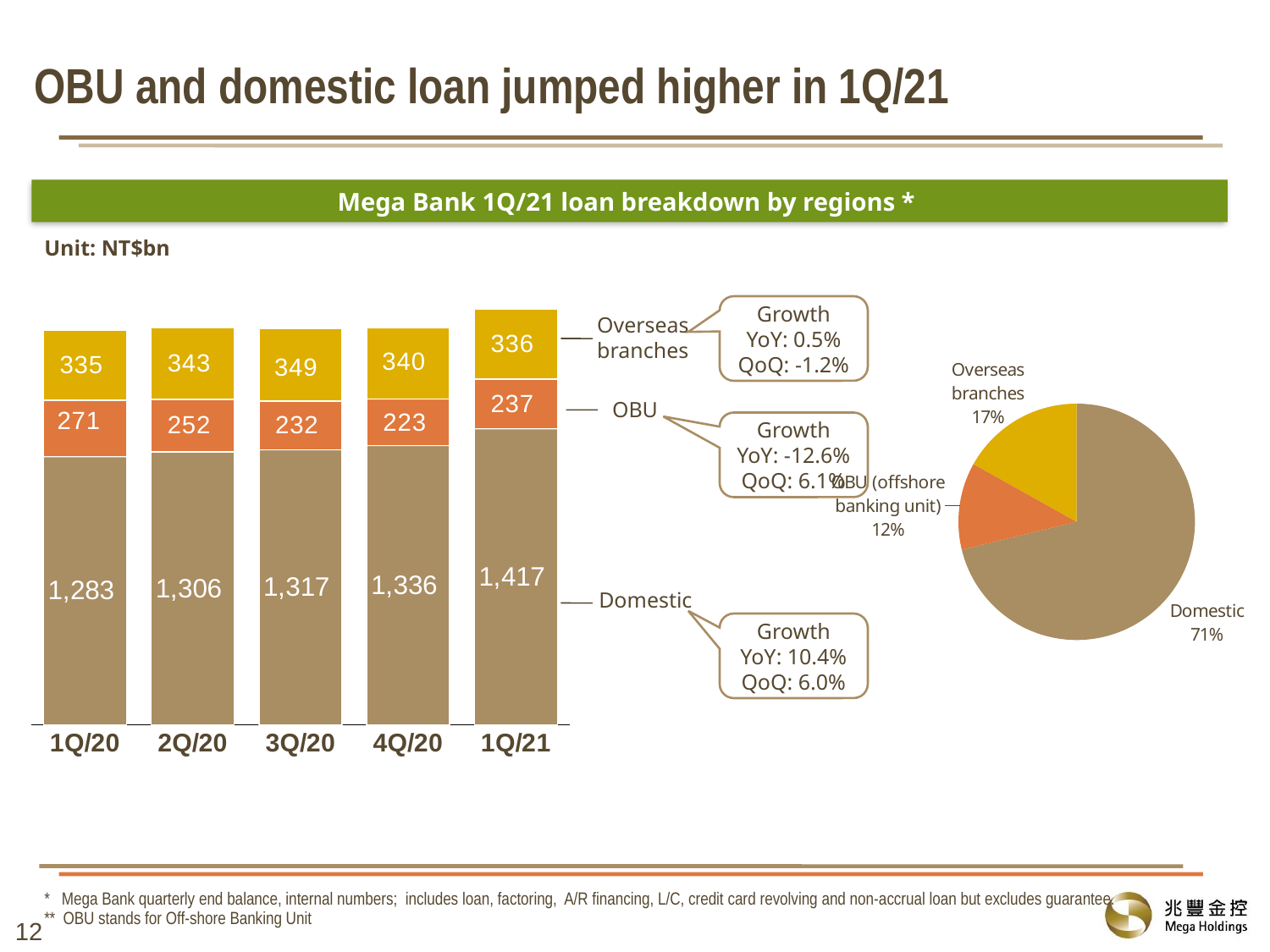
In the stacked bar chart, which quarter has the lowest OBU loan value? 4Q/20 In the stacked bar chart, what is the Domestic loan value for 1Q/21? 1,417 In the stacked bar chart, what is the OBU loan value for 4Q/20? 223 In the stacked bar chart, what is the difference between the Domestic loan values for 1Q/21 and 4Q/20? 81 In the pie chart, what share of loans is OBU (offshore banking unit)? 12% What kind of chart is used to show the quarterly loan breakdown? Stacked bar chart In the stacked bar chart, what is the Overseas branches loan value for 3Q/20? 349 In the pie chart, what share of loans is Domestic? 71% In the stacked bar chart, which quarter has the highest Domestic loan value? 1Q/21 How many quarters are shown in the stacked bar chart? 5 In the stacked bar chart, which is larger: the OBU value for 1Q/20 or the OBU value for 1Q/21? 1Q/20 In the stacked bar chart, what is the total loan value for 1Q/21 across all three segments? 1,990